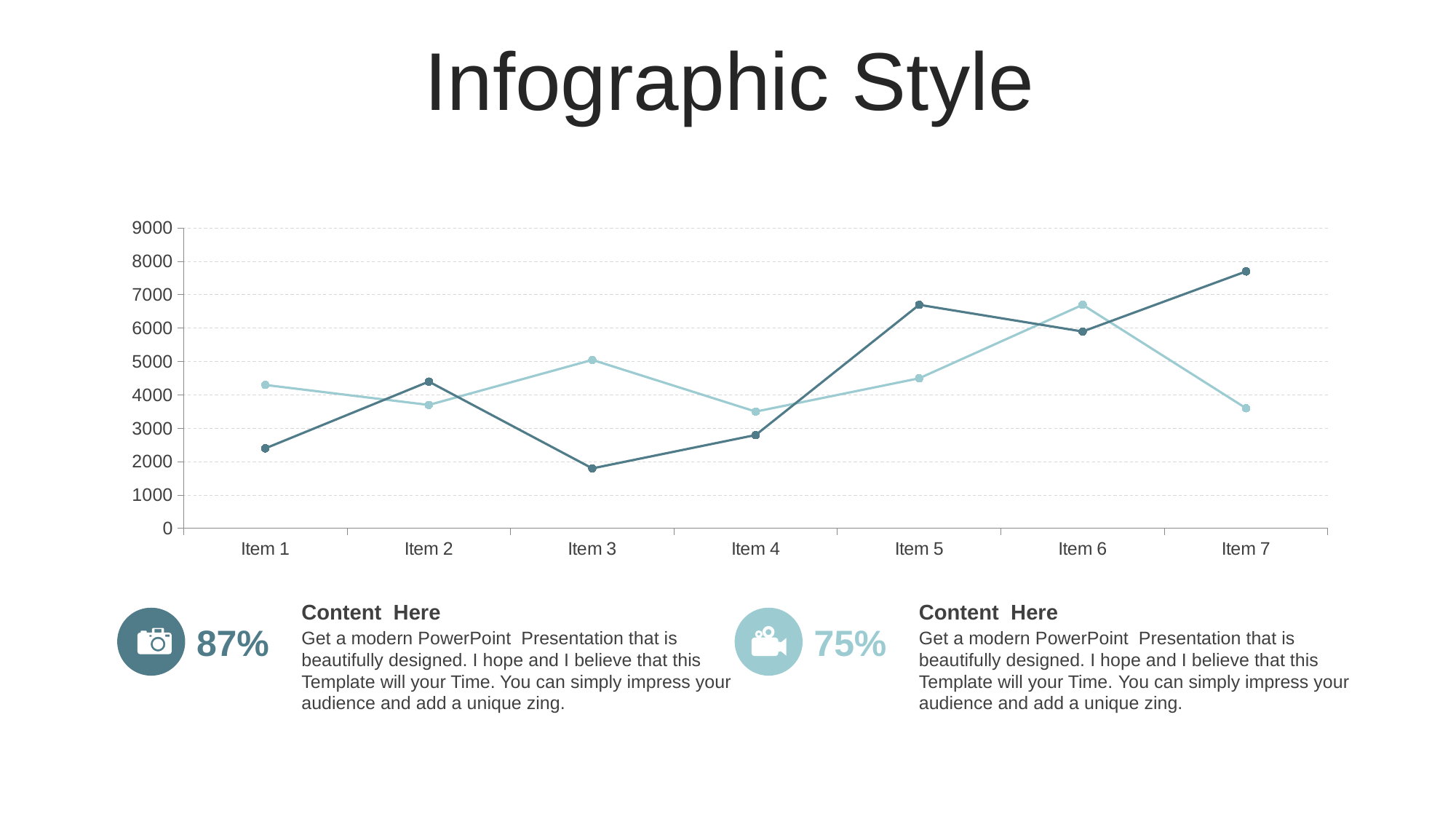
For the light line, which item has the highest value? Item 6 For the dark line, which item has the highest value? Item 7 Is the dark line's value for Item 5 greater or less than 6000? greater At Item 3, which line has the higher value, the dark line or the light line? the light line How many categories are plotted along the x axis of the chart? 7 For the dark line, which item has the lowest value? Item 3 What kind of chart is shown on the slide? line chart At Item 7, which line has the higher value, the dark line or the light line? the dark line Does the light line rise or fall from Item 6 to Item 7? fall Is the light line's value for Item 6 greater or less than 6000? greater How many lines (data series) are plotted on the chart? 2 Is the dark line's value for Item 3 greater or less than 2000? less